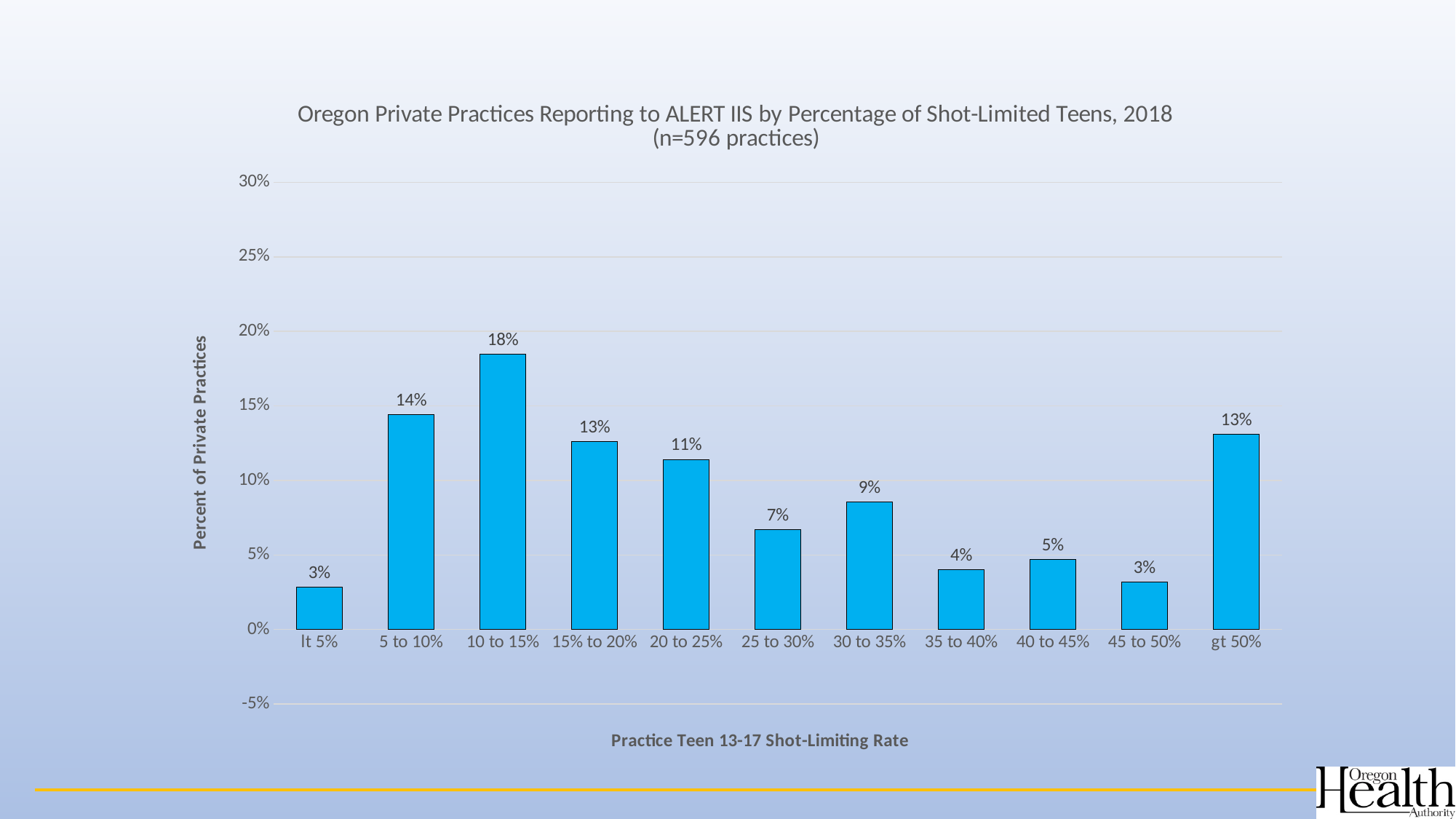
Which is larger, the value for 30 to 35% or the value for 40 to 45%? 30 to 35% What percent of private practices fall in the 10 to 15% shot-limiting rate category? 18% What is the difference between the values for the 5 to 10% and 35 to 40% categories? 10% What is the value shown for the 'gt 50%' category? 13% What percent of private practices are in the 25 to 30% category? 7% How many shot-limiting rate categories are shown on the x axis? 11 Which shot-limiting rate category has the highest percent of private practices? 10 to 15% What kind of chart is shown on the slide? Bar chart What is the label of the x axis? Practice Teen 13-17 Shot-Limiting Rate Is the value for the 15% to 20% category greater or less than 10%? greater What is the difference between the values for the 10 to 15% and 20 to 25% categories? 7% What is the value for the 'lt 5%' category? 3%